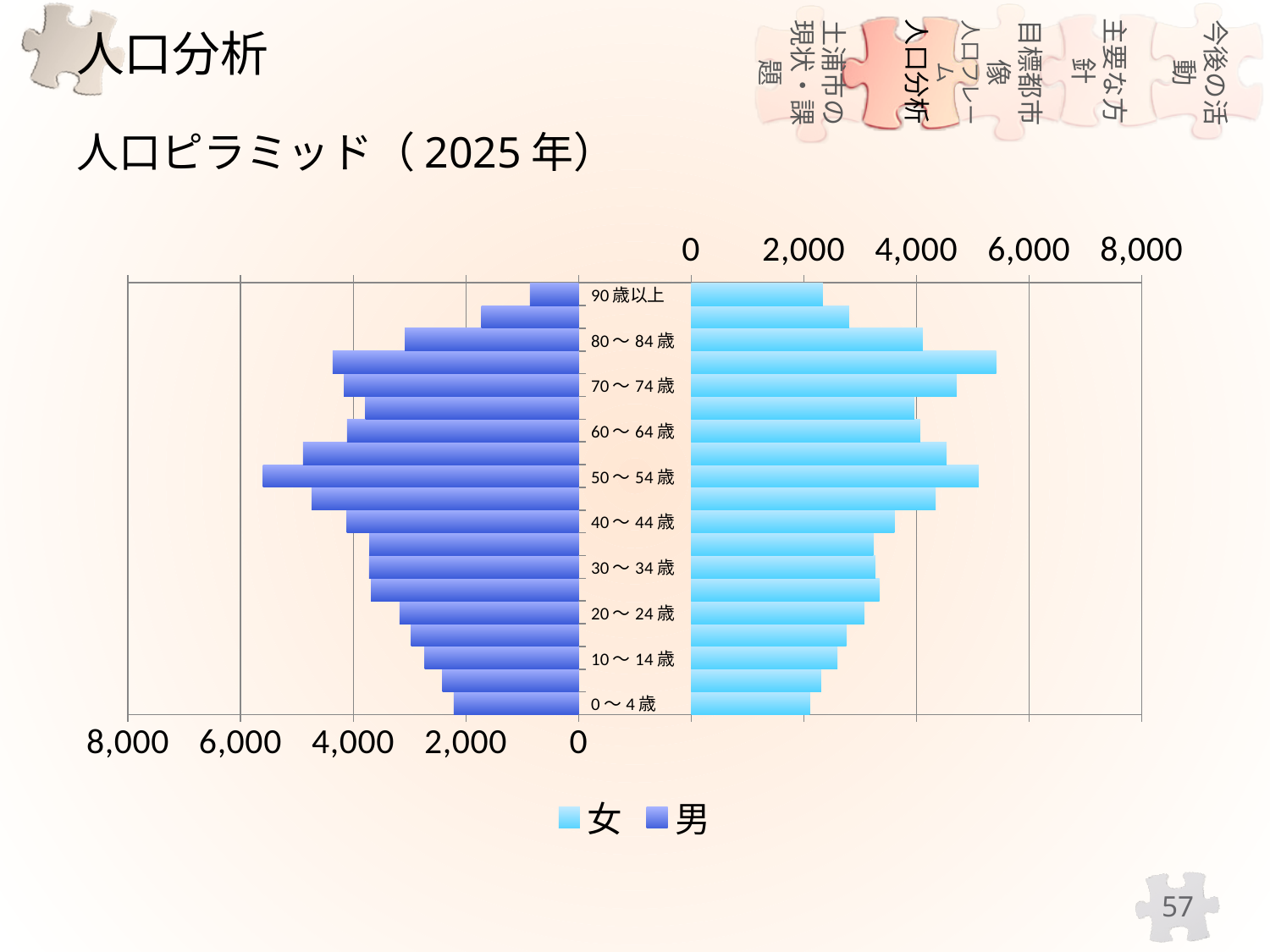
Is the value for 男 in the 50〜54歳 group greater or less than 4,000? greater For the 90歳以上 group, which is larger, the value for 女 or the value for 男? 女 Is the value for 女 in the 30〜34歳 group greater or less than 4,000? less Which age group has the lowest value for 男? 90歳以上 What is the title of the chart? 人口ピラミッド（2025年） What are the two series named in the legend? 女 and 男 Which age group has the highest value for 男? 50〜54歳 Is the value for 男 in the 90歳以上 group greater or less than 2,000? less How many series does the legend list? 2 What kind of chart is shown on the slide? bar chart